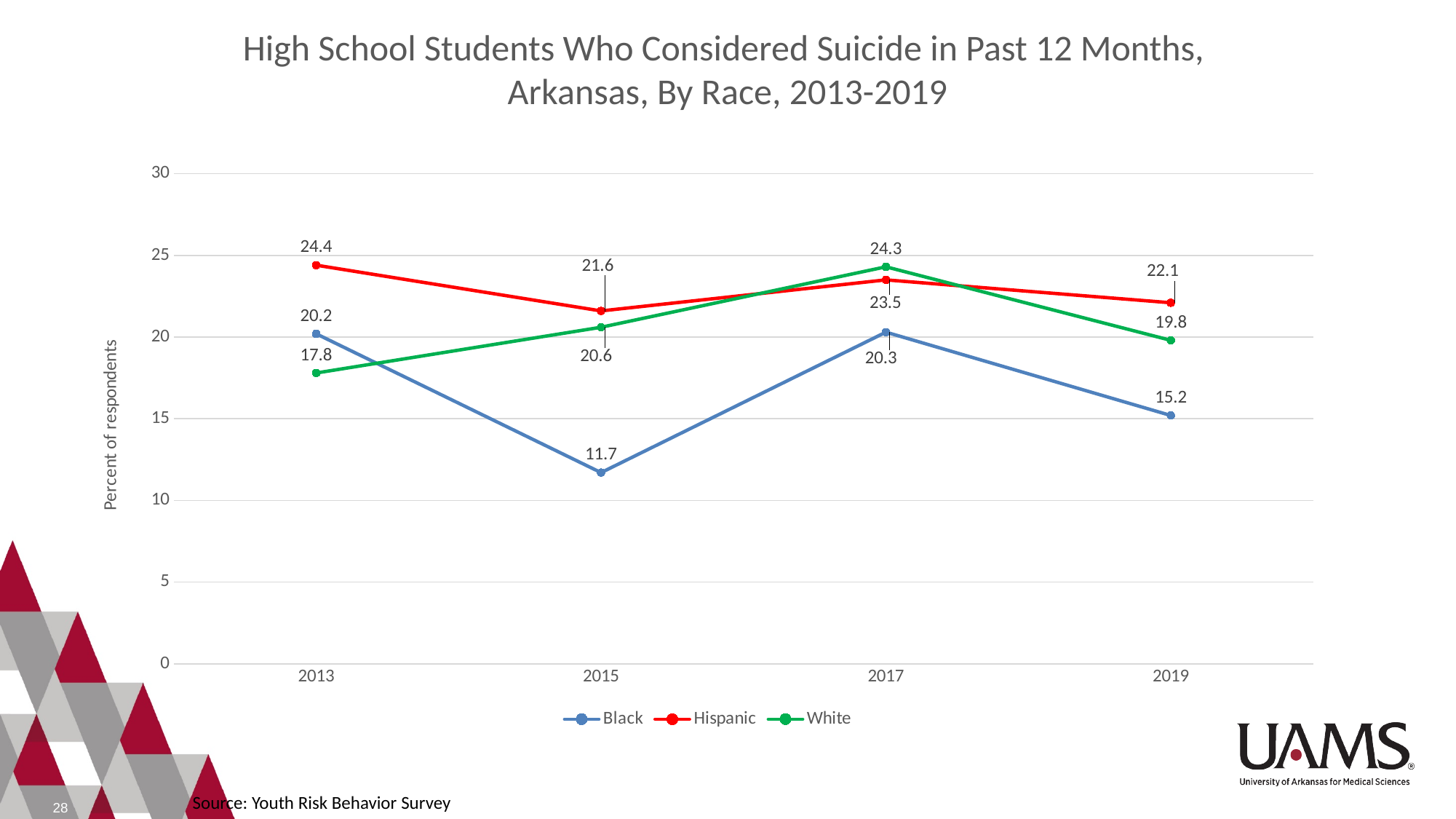
What was the value for Hispanic students in 2013? 24.4 What is the label on the y axis? Percent of respondents In which year was the value for Black students lowest? 2015 How many years are plotted on the x axis? 4 In which year was the value for White students highest? 2017 What type of chart is shown on the slide? Line chart Which series had the higher value in 2015, Black or White? White How many series does the legend list? 3 Did the value for Black students rise or fall from 2017 to 2019? Fall What was the value for White students in 2019? 19.8 What was the value for Black students in 2015? 11.7 What is the difference between the Hispanic and Black values in 2019? 6.9